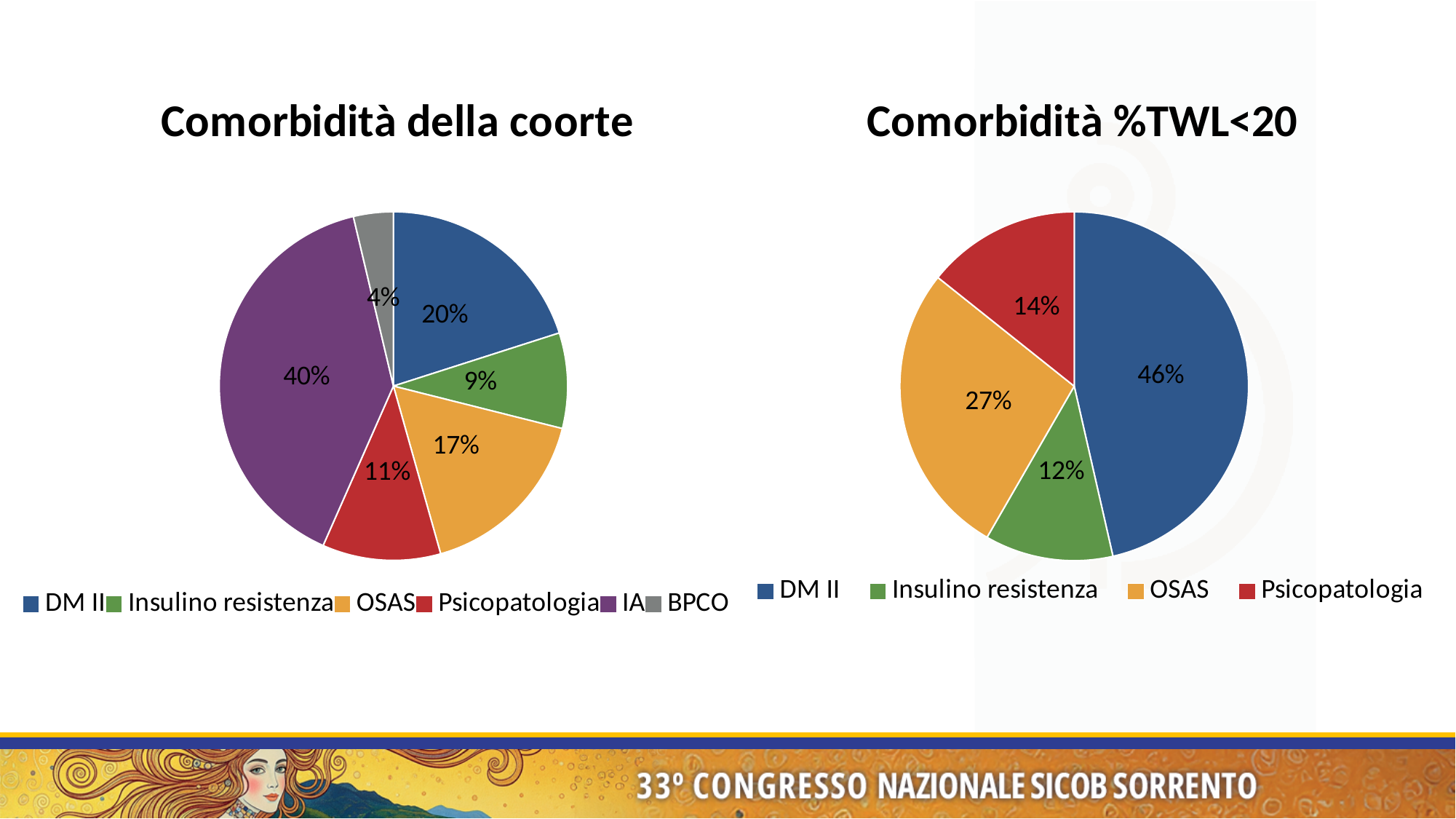
In the 'Comorbidità %TWL<20' chart, which category has the smallest slice? Insulino resistenza What kind of chart is 'Comorbidità della coorte'? Pie chart In the 'Comorbidità della coorte' chart, which category has the smallest slice? BPCO In the 'Comorbidità %TWL<20' chart, which is larger, OSAS or Psicopatologia? OSAS In the 'Comorbidità della coorte' chart, what is the difference between the DM II share and the Psicopatologia share? 9% In the 'Comorbidità della coorte' chart, how many categories does the legend list? 6 In the 'Comorbidità della coorte' chart, what share does IA have? 40% In the 'Comorbidità %TWL<20' chart, how many categories does the legend list? 4 In the 'Comorbidità %TWL<20' chart, what share does DM II have? 46% In the 'Comorbidità %TWL<20' chart, what share does Psicopatologia have? 14% In the 'Comorbidità della coorte' chart, what share does OSAS have? 17% In the 'Comorbidità della coorte' chart, which category has the largest slice? IA